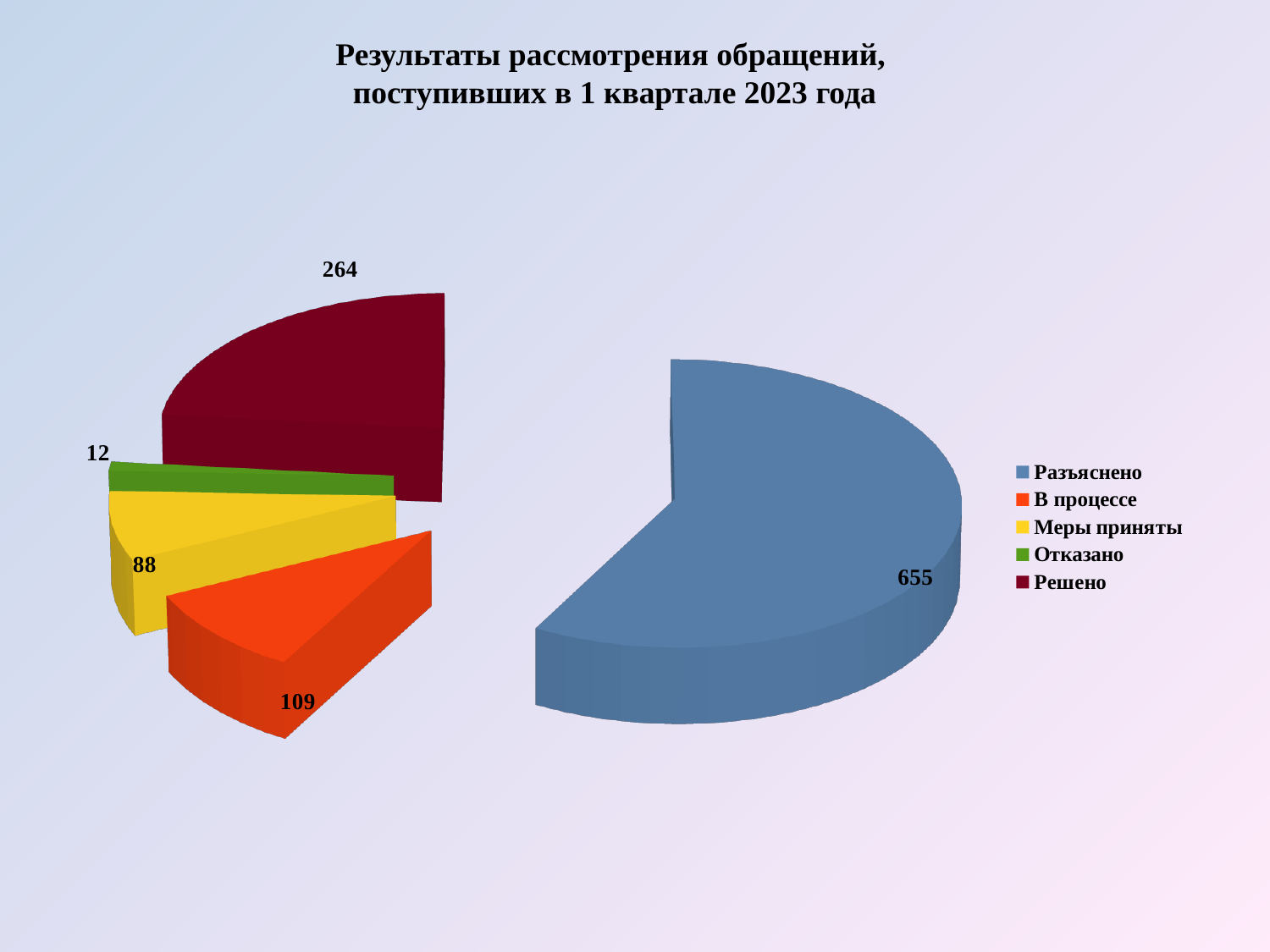
What is the value for Решено? 264 What is the total of all the slices in the pie chart? 1128 What kind of chart is shown on the slide? pie chart What is the value for Меры приняты? 88 Which category has the smallest slice? Отказано Which category has the largest slice? Разъяснено What is the difference between the values for Разъяснено and Решено? 391 What is the value for Разъяснено? 655 What is the value for В процессе? 109 Which is larger, В процессе or Меры приняты? В процессе How many categories does the pie chart have? 5 What is the value for Отказано? 12